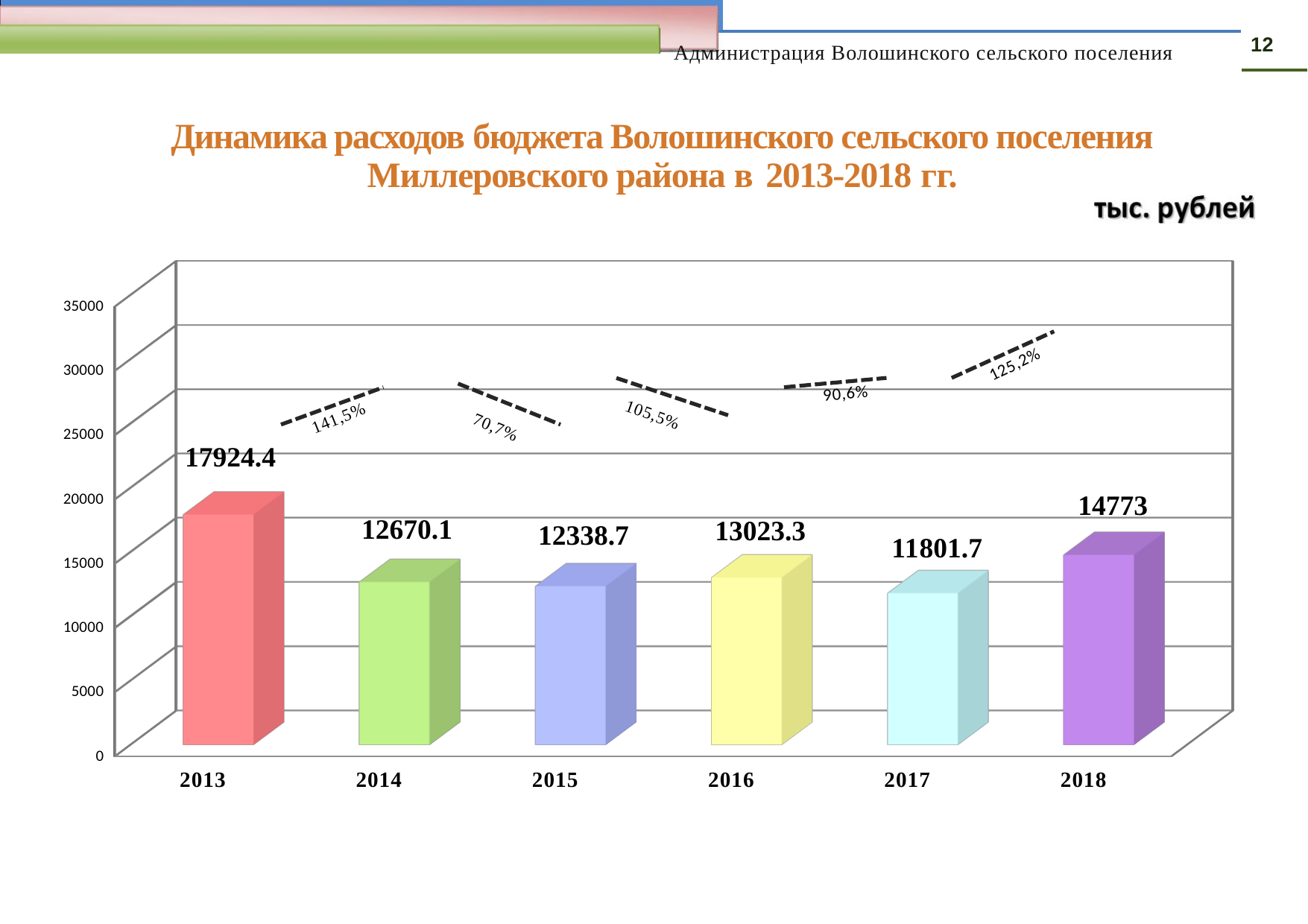
Is the value for 2017 greater or less than 15000? less What kind of chart is shown on the slide? bar chart Which is larger, the value for 2016 or the value for 2015? 2016 What is the value for 2016? 13023.3 Which year has the highest value? 2013 What is the value for 2013? 17924.4 What unit of measurement is indicated above the chart? тыс. рублей How many years are shown on the x axis? 6 What is the difference between the values for 2018 and 2017? 2971.3 What is the value for 2018? 14773 Which year has the lowest value? 2017 What is the difference between the values for 2013 and 2014? 5254.3